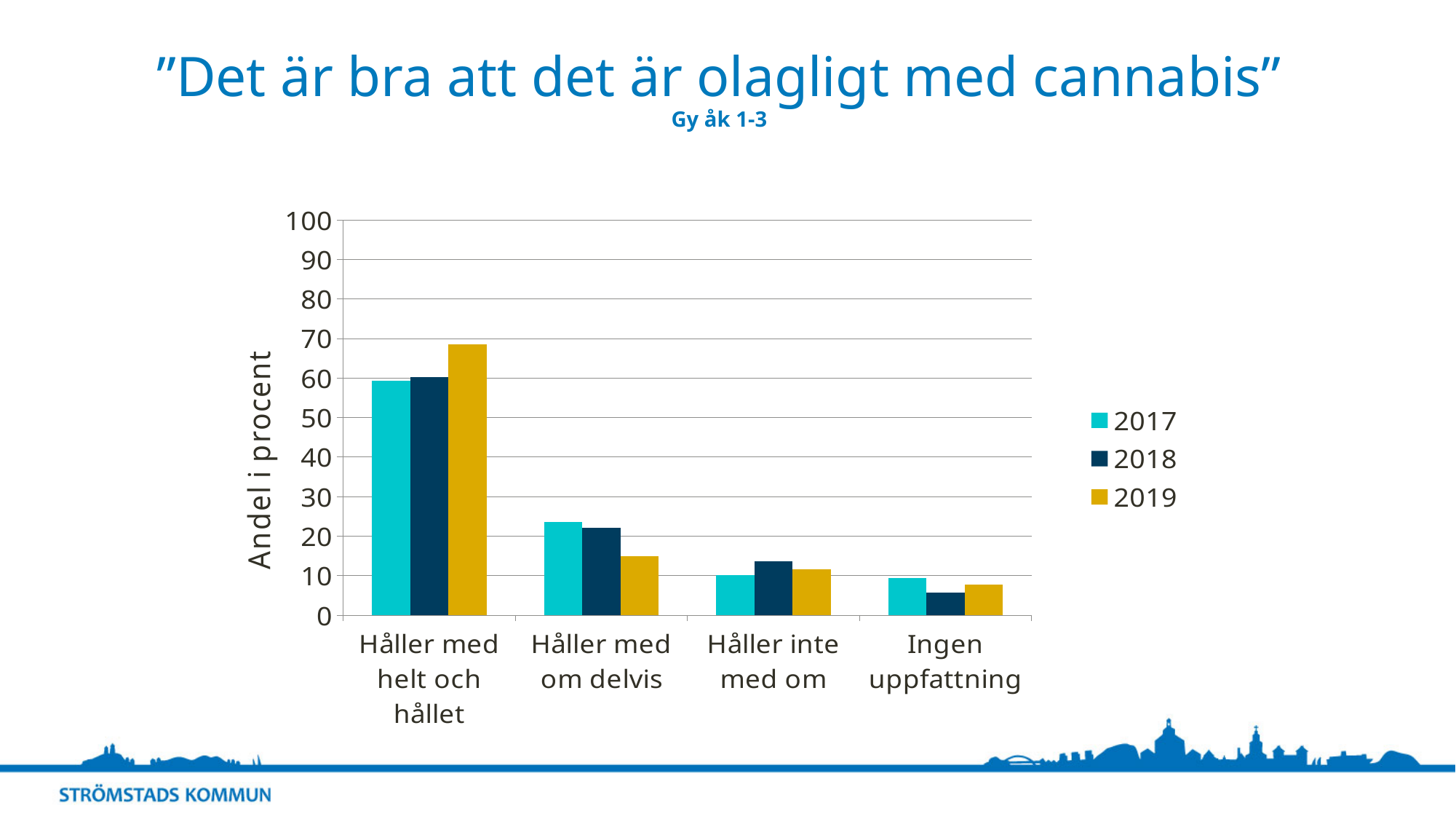
How many categories are shown on the x axis? 4 Is the value for 2019 in "Håller med om delvis" greater or less than 20? less How many series does the legend list? 3 In the category "Ingen uppfattning", which year has the lowest value? 2018 In the category "Håller med helt och hållet", which year has the highest value? 2019 What kind of chart is shown on the slide? bar chart In the category "Håller med om delvis", which is larger, the value for 2017 or the value for 2019? 2017 Is the value for 2018 in "Ingen uppfattning" greater or less than 10? less Is the value for 2019 in "Håller med helt och hållet" greater or less than 60? greater What is the title of the y axis? Andel i procent Which category has the highest value for 2019? Håller med helt och hållet